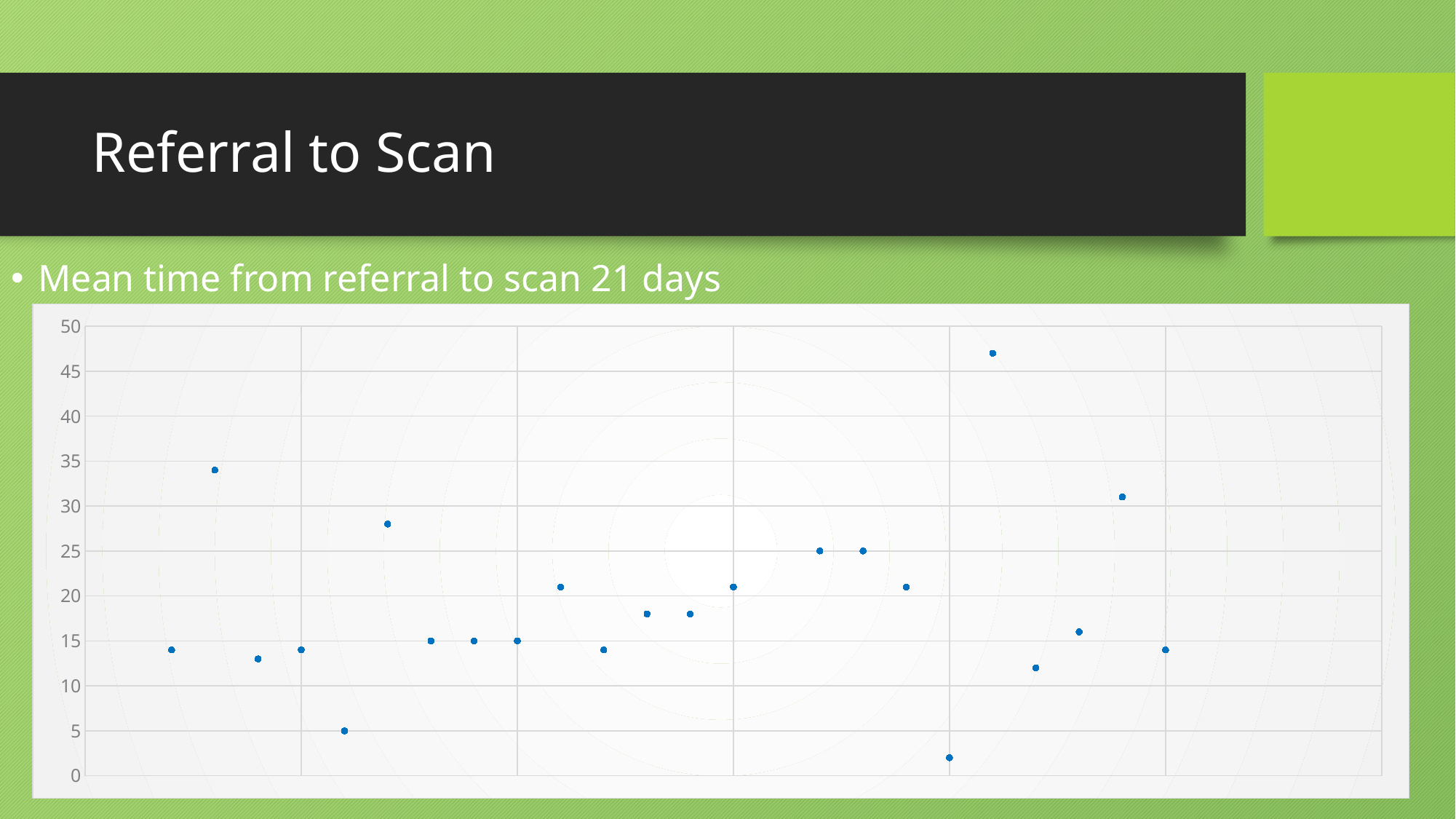
Is the lowest plotted point on the chart greater or less than 5? less How many plotted points lie below 10 on the y axis? 2 According to the slide text, what is the mean time from referral to scan? 21 days How many plotted points lie above 30 on the y axis? 3 How many data points are plotted on the chart? 23 What kind of chart is shown on the slide? scatter chart What is the highest value shown on the y axis of the chart? 50 Is the highest plotted point on the chart greater or less than 45? greater